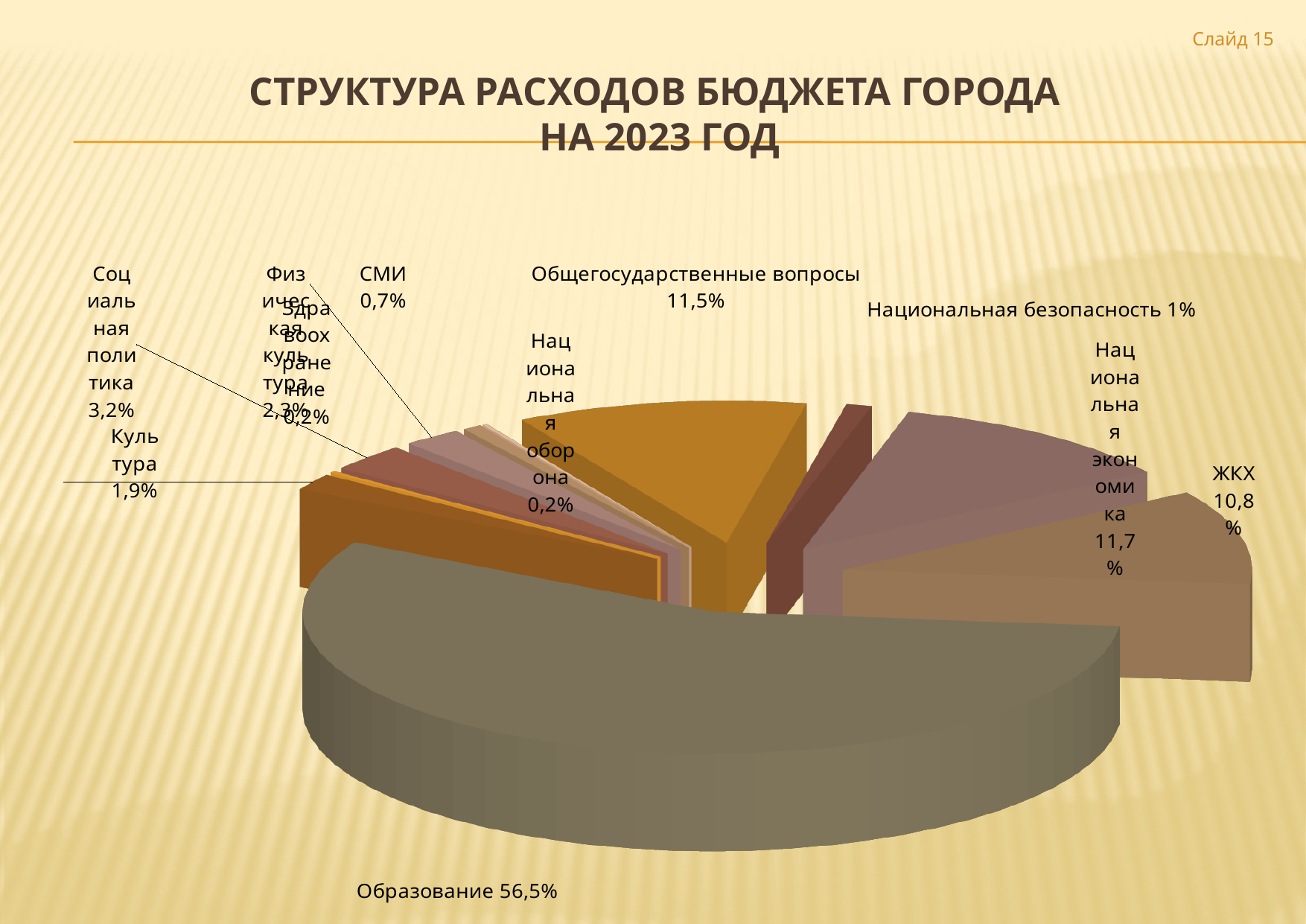
What is the difference between the shares of Социальная политика and Культура? 1,3 percentage points What is the value shown for Национальная безопасность? 1% What is the value shown for Общегосударственные вопросы? 11,5% How many categories are shown in the pie chart? 11 What type of chart is shown on the slide? Pie chart What share of the pie does Образование account for? 56,5% Which is larger, Национальная экономика or ЖКХ? Национальная экономика What is the value shown for ЖКХ? 10,8% What is the value shown for Социальная политика? 3,2% What is the difference between the shares of Образование and Общегосударственные вопросы? 45 percentage points What is the title of the chart on the slide? СТРУКТУРА РАСХОДОВ БЮДЖЕТА ГОРОДА НА 2023 ГОД Which category has the largest slice of the pie? Образование